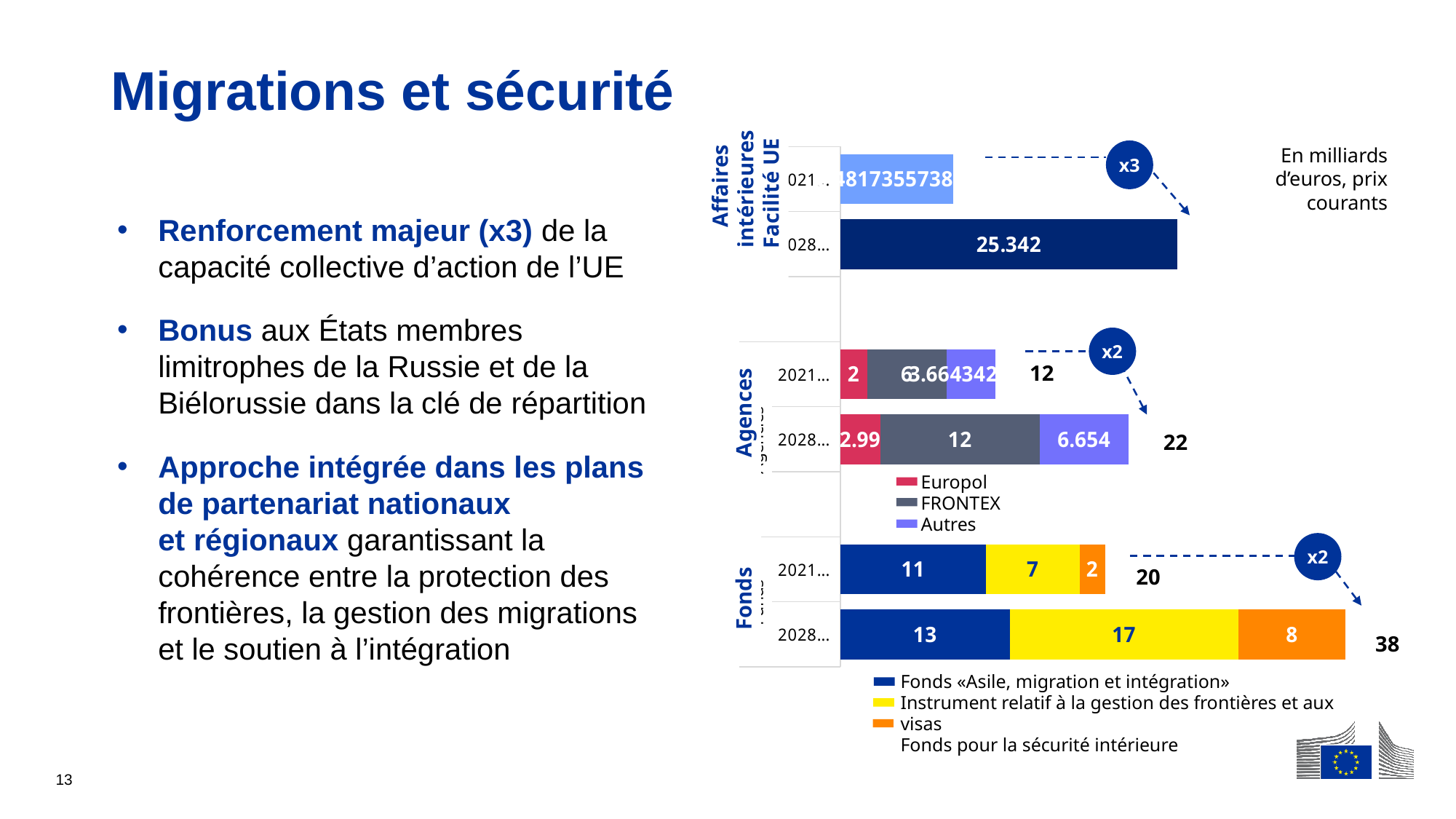
In the Agences chart, how many series does the legend list? 3 In the Agences chart, what is the value for Europol in the 2028 bar? 2.99 In the Affaires intérieures Facilité UE chart, what is the value of the 2028 bar? 25.342 In the Fonds chart, which is larger in the 2028 bar: Fonds «Asile, migration et intégration» or Instrument relatif à la gestion des frontières et aux visas? Instrument relatif à la gestion des frontières et aux visas In the Fonds chart, what is the difference between the 2028 total and the 2021 total? 18 What kind of chart is the Fonds chart? Stacked bar chart In the Agences chart, what is the value for FRONTEX in the 2028 bar? 12 In the Fonds chart, what is the total of the 2028 stacked bar? 38 In the Fonds chart, what is the value for Fonds «Asile, migration et intégration» in the 2028 bar? 13 In the Agences chart, what is the value for Autres in the 2028 bar? 6.654 In the Fonds chart, what is the value for Fonds pour la sécurité intérieure in the 2021 bar? 2 In the Fonds chart, what is the value for Instrument relatif à la gestion des frontières et aux visas in the 2028 bar? 17